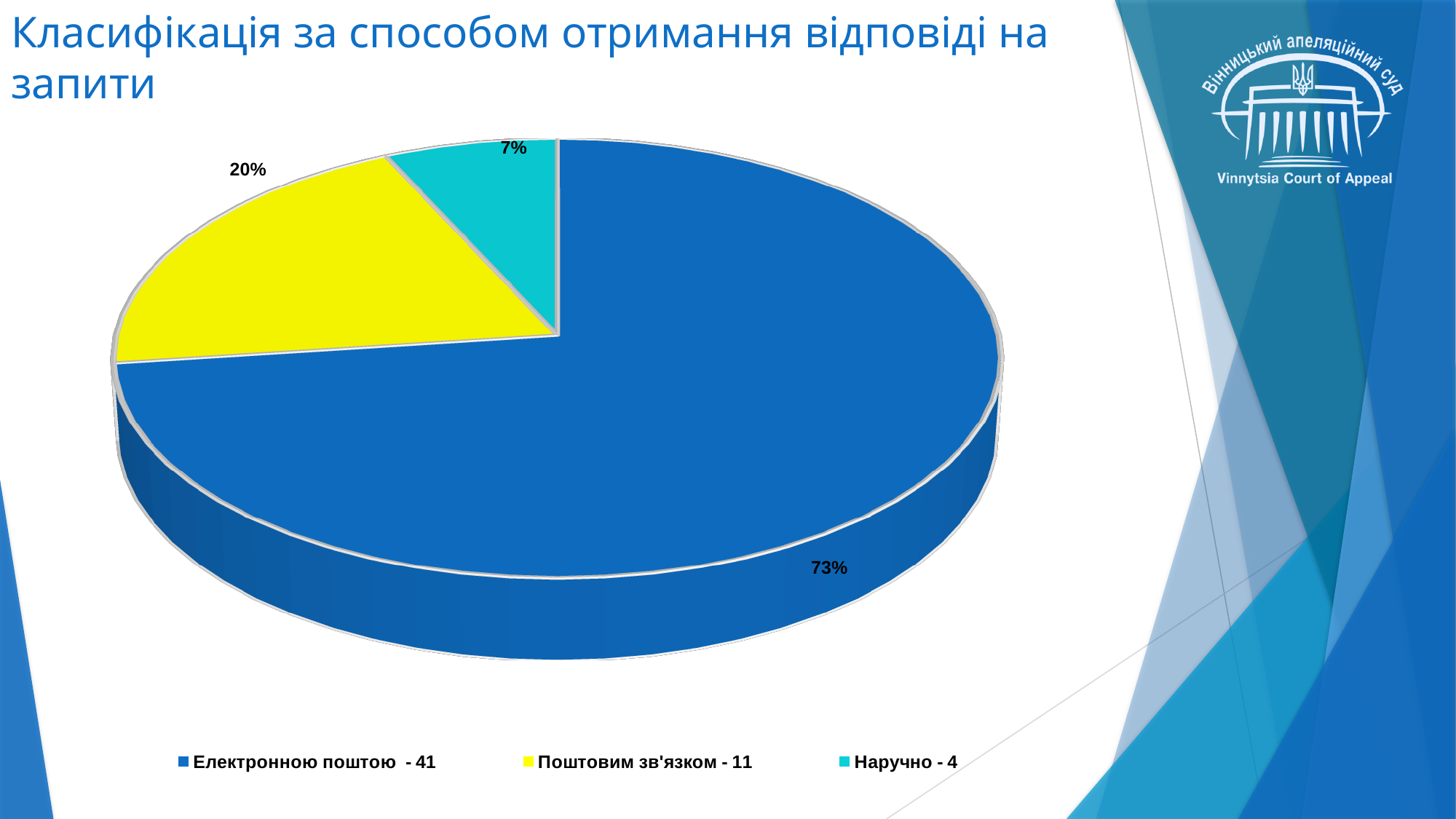
What count is given in the legend for 'Електронною поштою'? 41 What percentage share is shown for the slice 'Наручно'? 7% What kind of chart is shown on the slide? pie chart What colour is the 'Поштовим зв'язком' slice? yellow How many entries does the legend list? 3 Which category has the smallest slice of the pie? Наручно What percentage share is shown for the slice 'Поштовим зв'язком'? 20% Which category has the largest slice of the pie? Електронною поштою Which slice is larger: 'Поштовим зв'язком' or 'Наручно'? Поштовим зв'язком What percentage share is shown for the slice 'Електронною поштою'? 73% How many slices does the pie chart have? 3 What is the difference in percentage points between the 'Електронною поштою' slice and the 'Поштовим зв'язком' slice? 53%